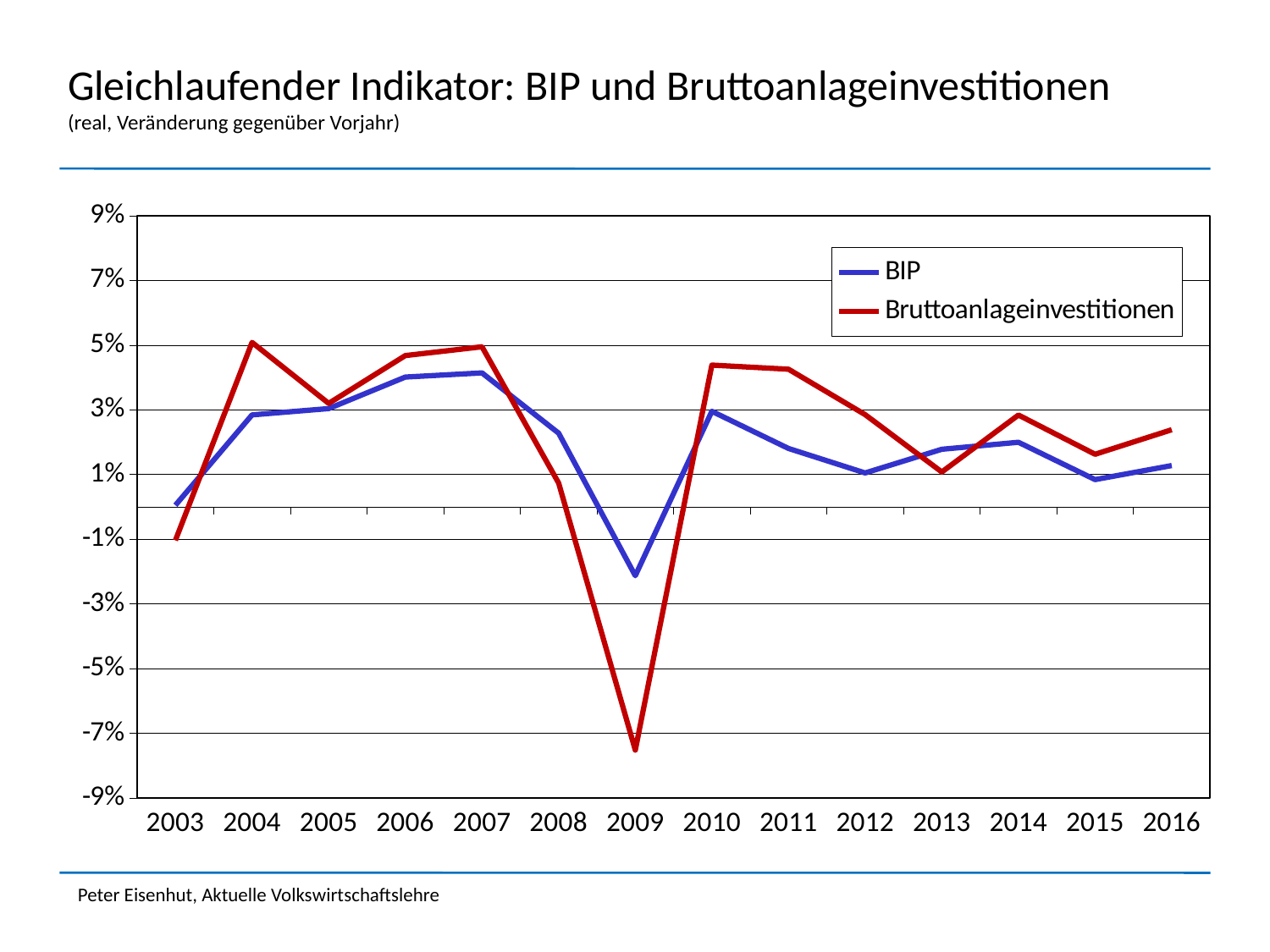
How many years are shown on the x axis? 14 In which year does the BIP series reach its lowest value? 2009 In 2008, which series has the higher value, BIP or Bruttoanlageinvestitionen? BIP Is the value for Bruttoanlageinvestitionen in 2009 greater or less than -7%? less Does the Bruttoanlageinvestitionen series rise or fall from 2010 to 2013? fall Is the value for Bruttoanlageinvestitionen in 2010 greater or less than 3%? greater Is the value for BIP in 2009 greater or less than -1%? less What kind of chart is shown on the slide? line chart In which year does the Bruttoanlageinvestitionen series reach its lowest value? 2009 How many series does the legend list? 2 Which colour is used for the BIP line? blue In 2012, which series has the higher value, BIP or Bruttoanlageinvestitionen? Bruttoanlageinvestitionen